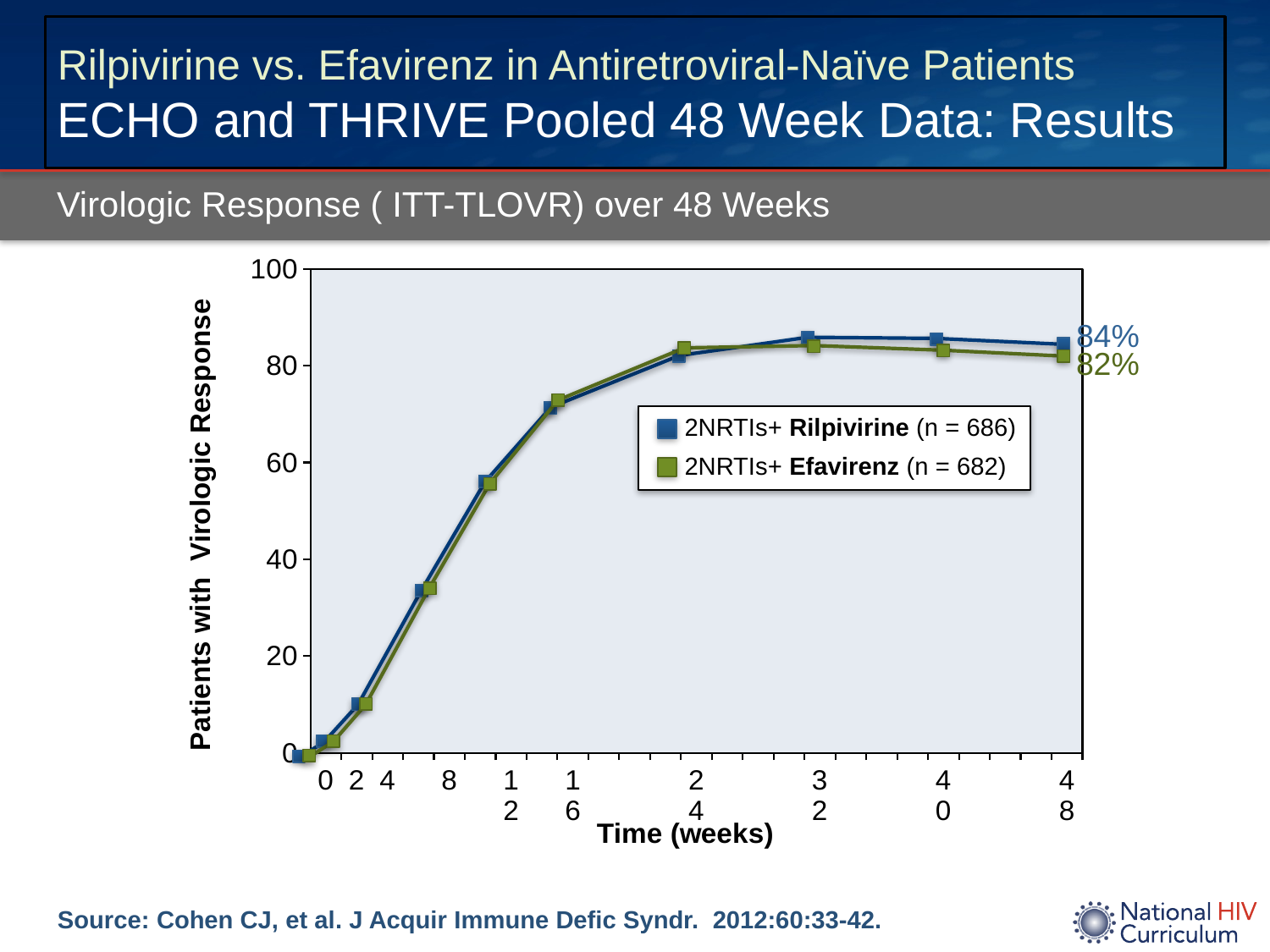
At week 48, which series has the higher virologic response, Rilpivirine or Efavirenz? Rilpivirine Is the value for Efavirenz at week 16 greater or less than 60? greater How many series does the legend list? 2 Do the values for Rilpivirine rise or fall from week 0 to week 48? Rise How many time points are labelled on the x axis? 10 Is the value for Rilpivirine at week 4 greater or less than 20? less What is the value for 2NRTIs+ Efavirenz at week 48? 82% What kind of chart is shown on the slide? Line chart What is the value for 2NRTIs+ Rilpivirine at week 48? 84% What is the difference between the Rilpivirine and Efavirenz values at week 48? 2% Is the value for Rilpivirine at week 8 greater or less than 40? less According to the legend, how many patients were in the 2NRTIs+ Rilpivirine group? 686